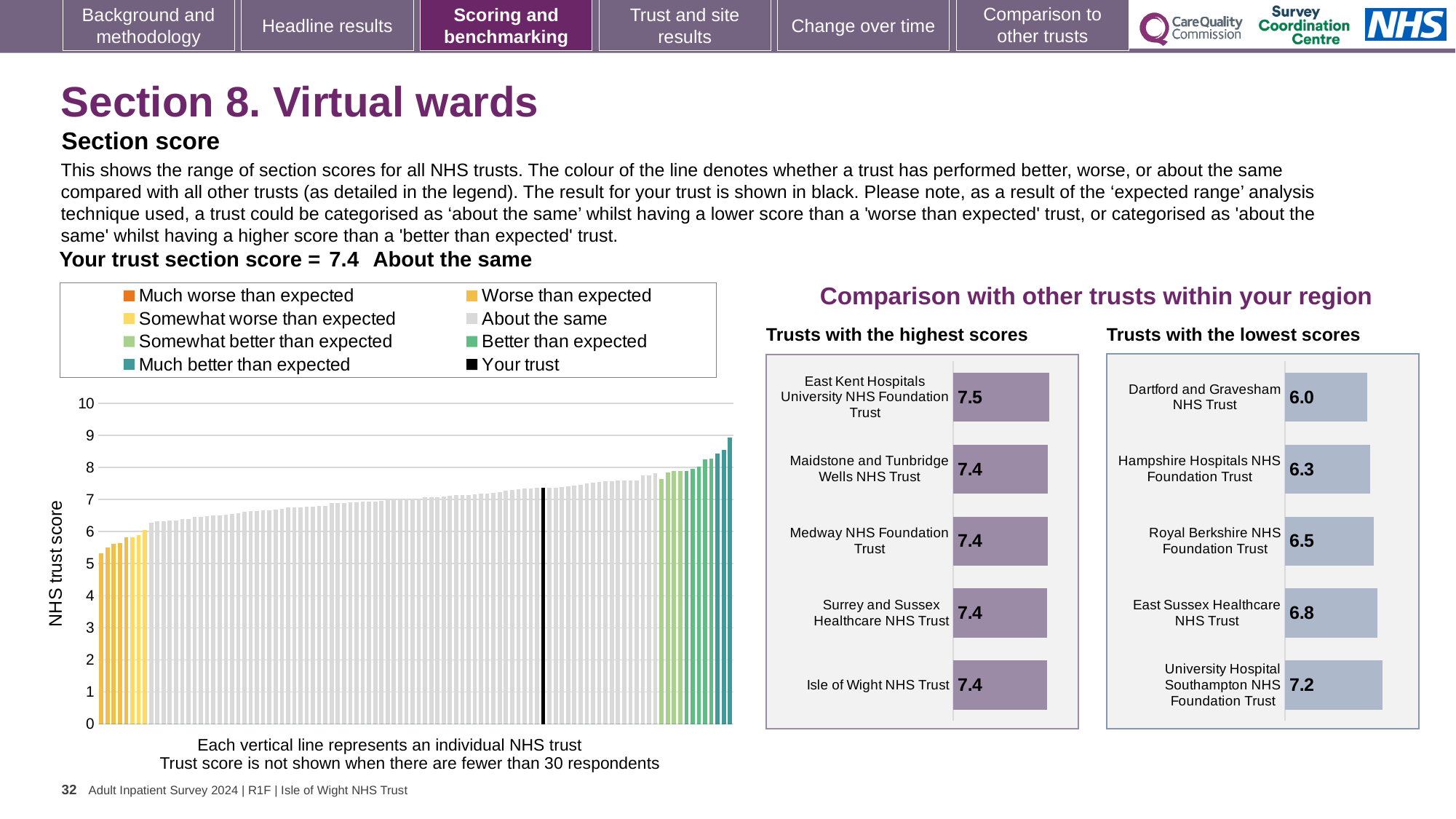
How many entries does the legend of the main NHS trust score chart list? 8 In the 'Trusts with the highest scores' chart, what is the score for East Kent Hospitals University NHS Foundation Trust? 7.5 In the main NHS trust score chart, do the values rise or fall from left to right? Rise In the 'Trusts with the lowest scores' chart, what is the difference between the scores of University Hospital Southampton NHS Foundation Trust and Dartford and Gravesham NHS Trust? 1.2 In the 'Trusts with the highest scores' chart, which trust has the highest score? East Kent Hospitals University NHS Foundation Trust What is the y-axis label of the main chart on the left? NHS trust score In the 'Trusts with the lowest scores' chart, what is the score for Royal Berkshire NHS Foundation Trust? 6.5 What kind of chart is the main chart showing the range of NHS trust scores? Bar chart In the 'Trusts with the lowest scores' chart, which trust has the lowest score? Dartford and Gravesham NHS Trust How many trusts are shown in the 'Trusts with the highest scores' chart? 5 In the 'Trusts with the lowest scores' chart, which has the larger score: Hampshire Hospitals NHS Foundation Trust or East Sussex Healthcare NHS Trust? East Sussex Healthcare NHS Trust In the main NHS trust score chart, is the value of the tallest bar greater or less than 8? greater